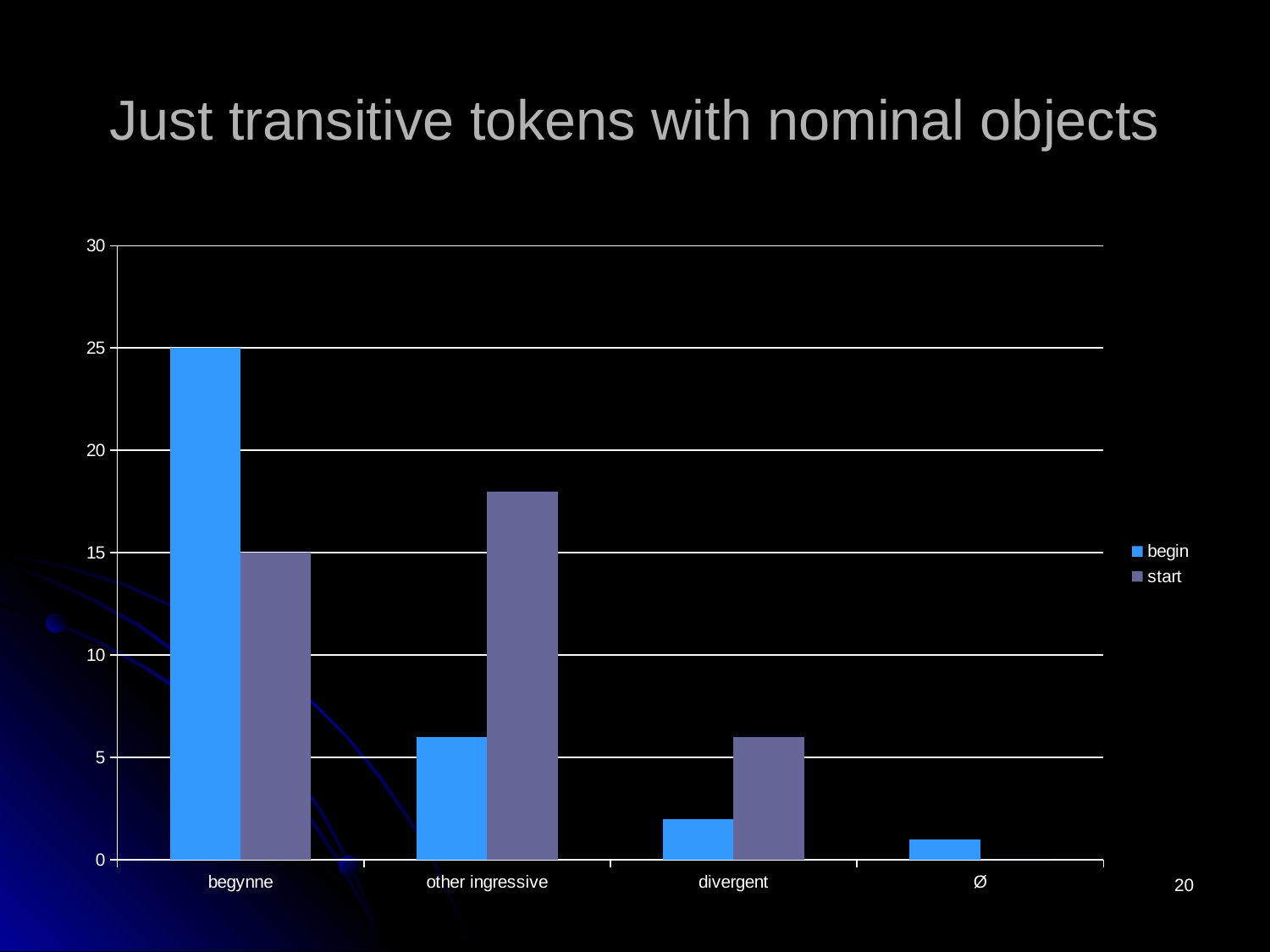
What is the value of the begin series for begynne? 25 What is the difference between the begin and start values for begynne? 10 For other ingressive, which series has the larger value, begin or start? start For begynne, which series has the larger value, begin or start? begin Which category has the highest value for the begin series? begynne How many series does the legend list? 2 Is the value of the start series for other ingressive greater or less than 15? greater How many categories are shown on the x axis? 4 What kind of chart is shown on the slide? bar chart What is the value of the start series for begynne? 15 Which category has the highest value for the start series? other ingressive Is the value of the begin series for other ingressive greater or less than 10? less